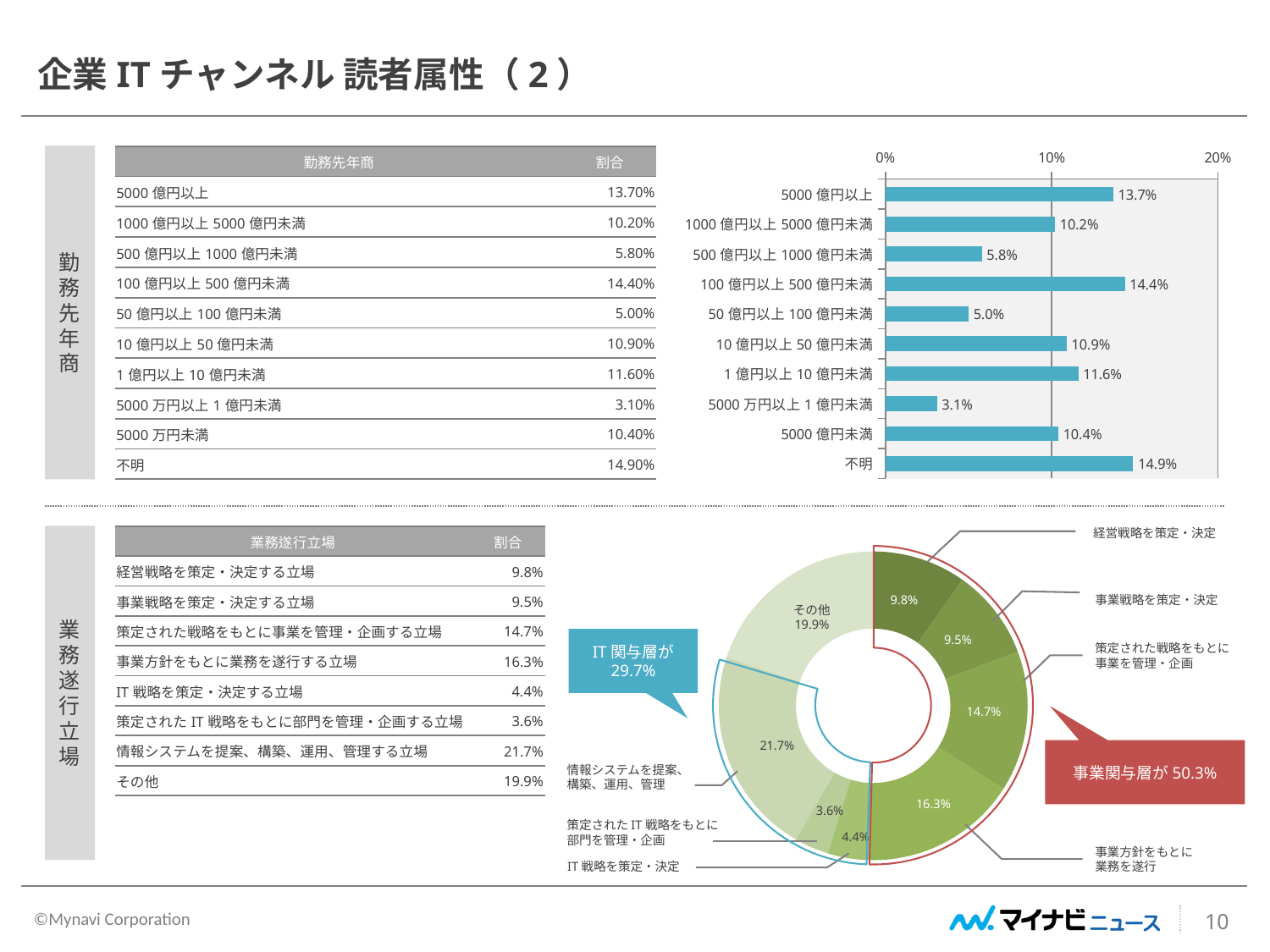
In the bar chart at the top of the slide (勤務先年商), which category has the highest value? 不明 In the bar chart at the top of the slide (勤務先年商), what is the value for 5000 億円以上? 13.7% In the donut chart at the bottom of the slide (業務遂行立場), which segment has the smallest share? 策定された IT 戦略をもとに部門を管理・企画 In the bar chart at the top of the slide (勤務先年商), what is the value for 100 億円以上 500 億円未満? 14.4% How many segments are shown in the donut chart at the bottom of the slide (業務遂行立場)? 8 How many categories are shown in the bar chart at the top of the slide (勤務先年商)? 10 In the bar chart at the top of the slide (勤務先年商), which category has the lowest value? 5000 万円以上 1 億円未満 What kind of chart is the chart at the top right of the slide (勤務先年商)? Bar chart In the donut chart at the bottom of the slide (業務遂行立場), what is the share for 事業方針をもとに業務を遂行? 16.3% In the bar chart at the top of the slide (勤務先年商), which is larger: 10 億円以上 50 億円未満 or 500 億円以上 1000 億円未満? 10 億円以上 50 億円未満 In the bar chart at the top of the slide (勤務先年商), what is the difference between the values for 1 億円以上 10 億円未満 and 50 億円以上 100 億円未満? 6.6% In the donut chart at the bottom of the slide (業務遂行立場), which segment has the largest share? 情報システムを提案、構築、運用、管理